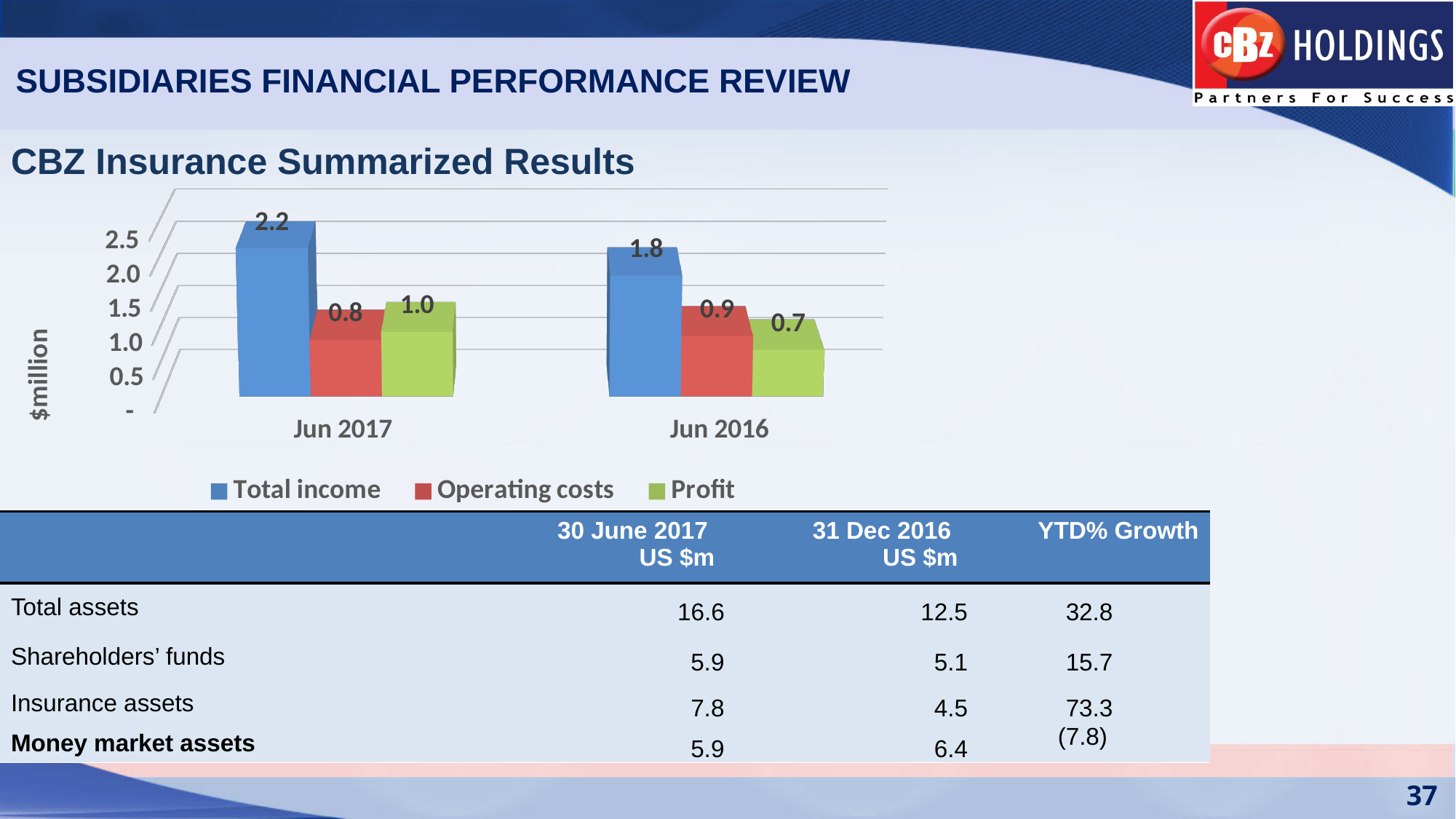
What are the Operating costs for Jun 2017? 0.8 Which period has the higher Total income? Jun 2017 What is the Total income for Jun 2016? 1.8 What is the difference in Total income between Jun 2017 and Jun 2016? 0.4 How many series does the legend list? 3 What is the label on the vertical axis? $million What is the Total income for Jun 2017? 2.2 What is the Profit for Jun 2016? 0.7 Which series has the lowest value in Jun 2016? Profit What is the difference in Profit between Jun 2017 and Jun 2016? 0.3 How many periods are shown on the x axis? 2 What kind of chart is shown? Bar chart